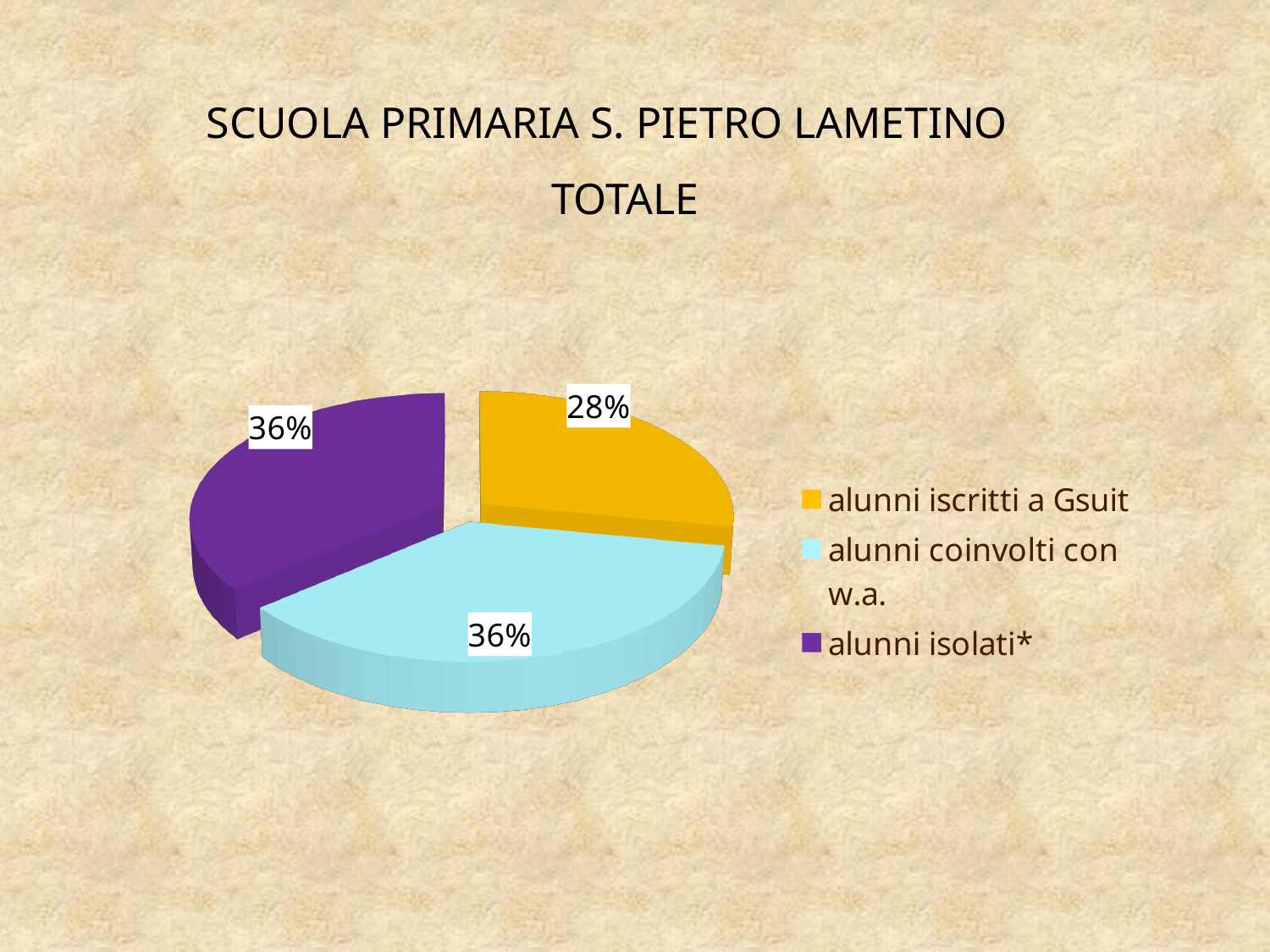
Which is larger: the slice for "alunni coinvolti con w.a." or the slice for "alunni iscritti a Gsuit"? alunni coinvolti con w.a. What colour is the slice for "alunni isolati*"? purple How many slices does the pie chart have? 3 What share of the pie is labelled for "alunni iscritti a Gsuit"? 28% Which category has the smallest slice of the pie? alunni iscritti a Gsuit Which is larger: the slice for "alunni iscritti a Gsuit" or the slice for "alunni isolati*"? alunni isolati* What share of the pie is labelled for "alunni coinvolti con w.a."? 36% What kind of chart is shown on the slide? pie chart How many entries does the legend list? 3 What is the difference in percentage points between the "alunni isolati*" slice and the "alunni iscritti a Gsuit" slice? 8 percentage points What is the title shown above the chart? SCUOLA PRIMARIA S. PIETRO LAMETINO TOTALE What share of the pie is labelled for "alunni isolati*"? 36%